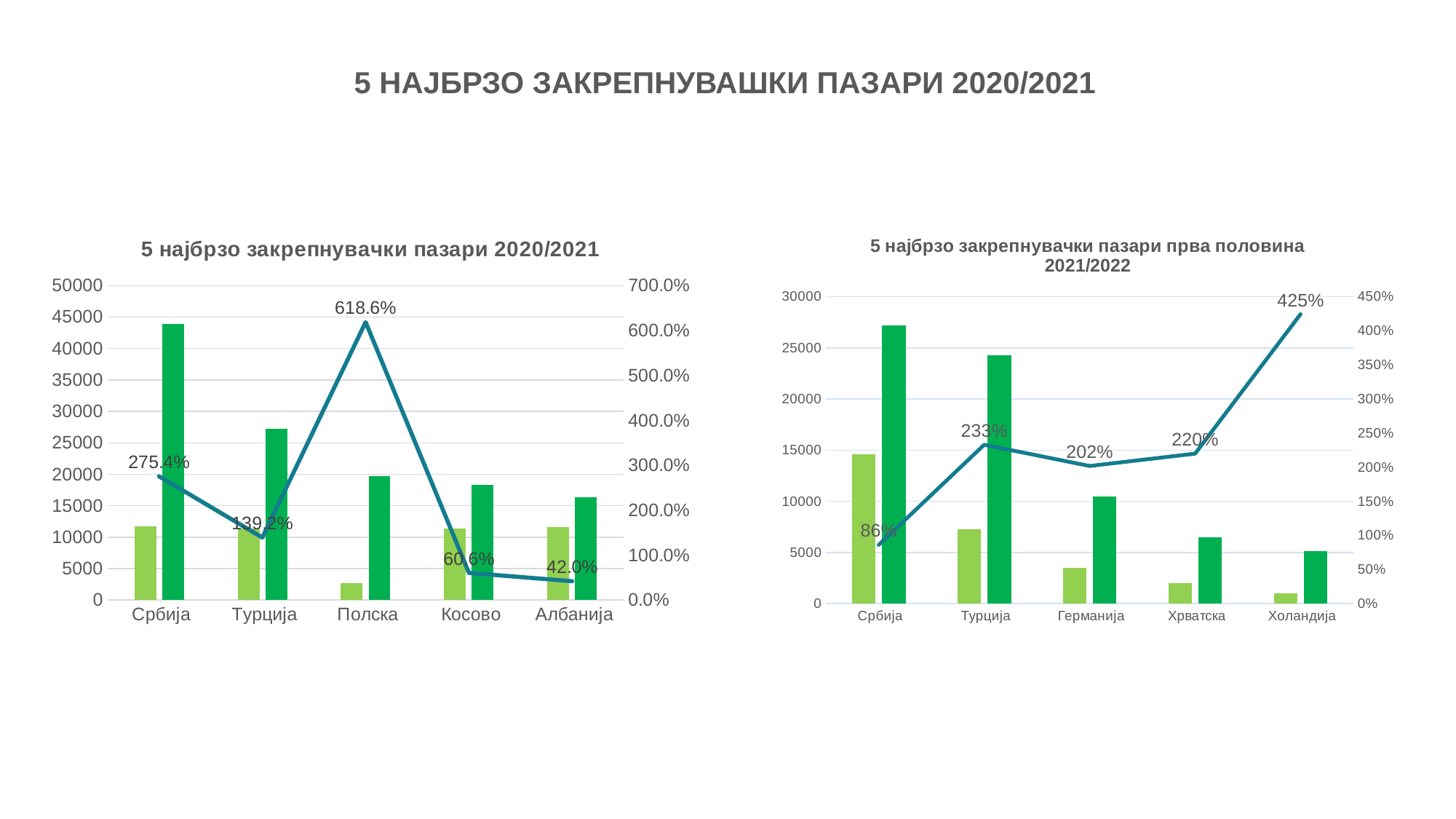
In the left chart (5 најбрзо закрепнувачки пазари 2020/2021), is the dark green bar for Србија greater or less than 40000? greater In the right chart (5 најбрзо закрепнувачки пазари прва половина 2021/2022), which category has the lowest percentage on the line? Србија In the right chart (5 најбрзо закрепнувачки пазари прва половина 2021/2022), what percentage is labelled on the line for Холандија? 425% In the right chart (5 најбрзо закрепнувачки пазари прва половина 2021/2022), how many categories are shown on the x axis? 5 In the left chart (5 најбрзо закрепнувачки пазари 2020/2021), which category has the lowest percentage on the line? Албанија In the left chart (5 најбрзо закрепнувачки пазари 2020/2021), what percentage is labelled on the line for Србија? 275.4% What kind of chart is the left chart (5 најбрзо закрепнувачки пазари 2020/2021)? Combined bar and line chart In the left chart (5 најбрзо закрепнувачки пазари 2020/2021), is the light green bar for Полска greater or less than 5000? less In the left chart (5 најбрзо закрепнувачки пазари 2020/2021), what percentage is labelled on the line for Полска? 618.6% In the right chart (5 најбрзо закрепнувачки пазари прва половина 2021/2022), which has the higher line percentage, Турција or Хрватска? Турција In the right chart (5 најбрзо закрепнувачки пазари прва половина 2021/2022), what is the difference between the line percentages for Холандија and Србија? 339 percentage points In the left chart (5 најбрзо закрепнувачки пазари 2020/2021), what is the difference between the line percentages for Полска and Србија? 343.2 percentage points